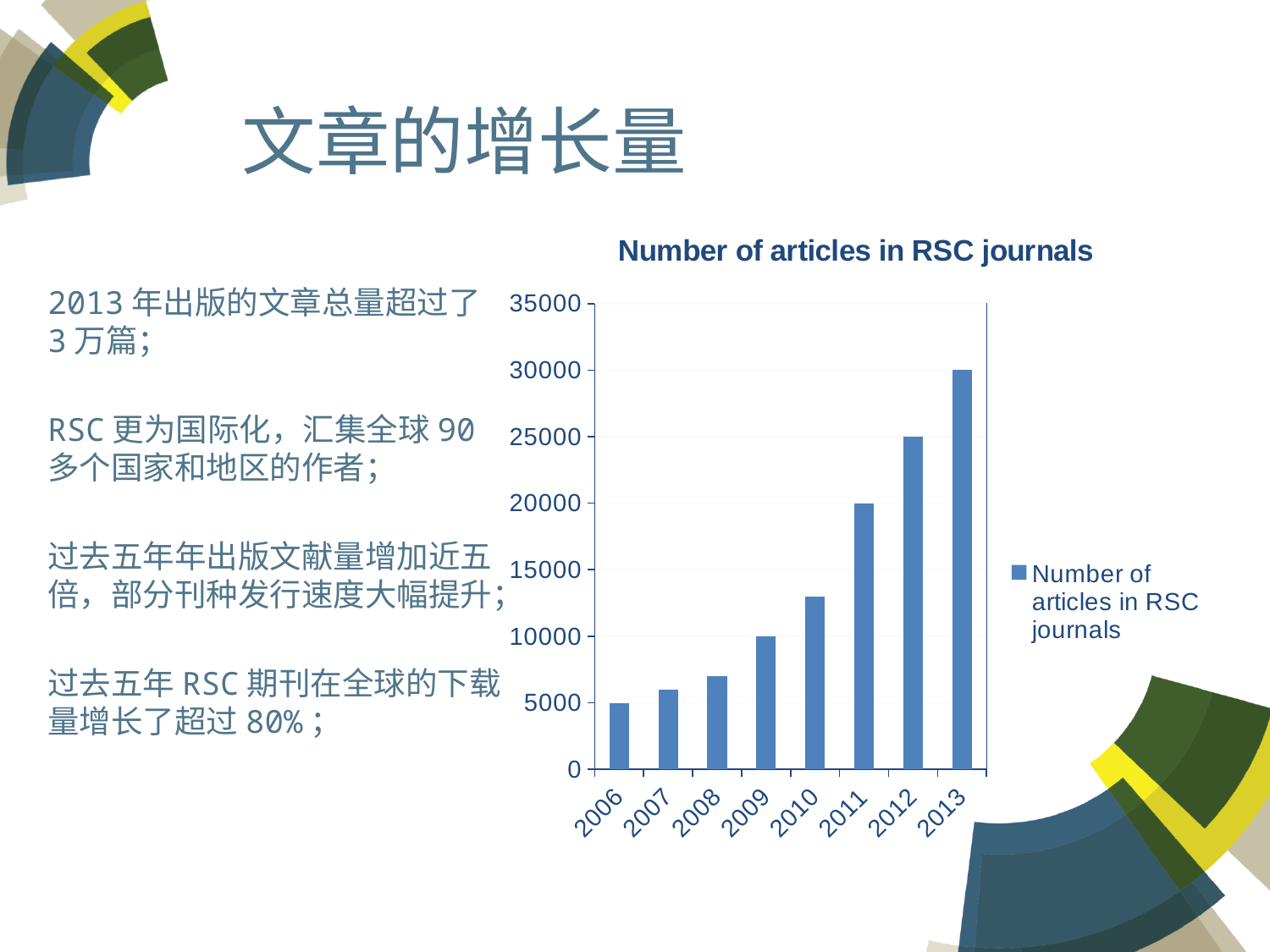
Is the value for 2007 greater or less than 5000? greater What is the number of articles in RSC journals in 2012? 25000 Is the value for 2010 greater or less than 15000? less Do the values rise or fall from 2006 to 2013? rise What kind of chart is shown on the slide? bar chart Which year has the lowest number of articles in RSC journals? 2006 What is the title of the chart? Number of articles in RSC journals How many series does the legend list? 1 What is the number of articles in RSC journals in 2013? 30000 What is the number of articles in RSC journals in 2011? 20000 How many years are shown on the x axis of the chart? 8 Which year has the highest number of articles in RSC journals? 2013